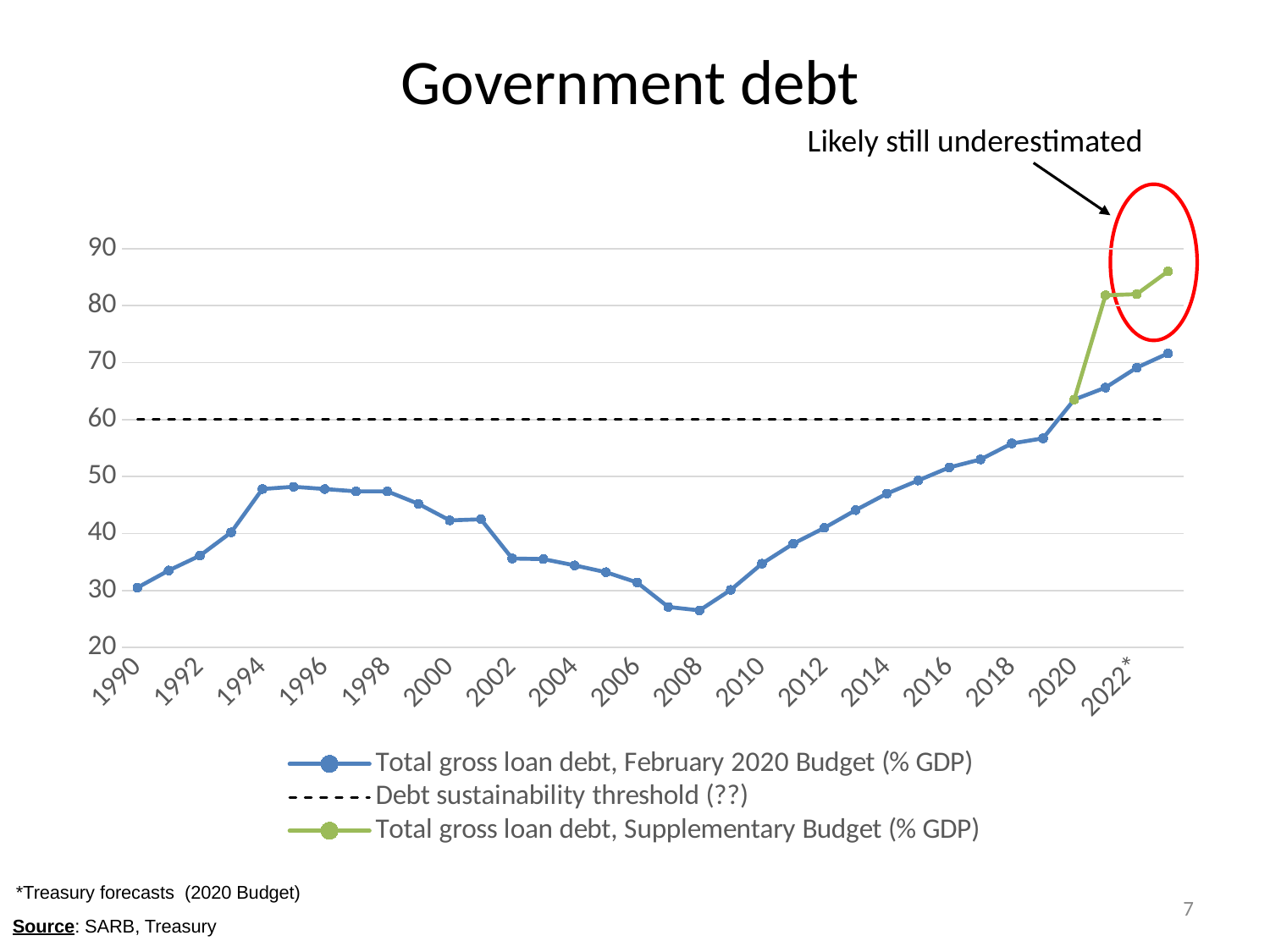
At what level on the y axis is the Debt sustainability threshold line drawn? 60 Is the value for Total gross loan debt, Supplementary Budget at the last point (after 2022*) greater or less than 80? greater At the final point on the right of the chart, which series is higher: Total gross loan debt, Supplementary Budget or Total gross loan debt, February 2020 Budget? Total gross loan debt, Supplementary Budget Is the value for Total gross loan debt, February 2020 Budget in 2020 greater or less than 60? greater In which year does the Total gross loan debt, February 2020 Budget series reach its lowest value? 2008 What colour is the line for Total gross loan debt, Supplementary Budget (% GDP)? green Is the value for Total gross loan debt, February 2020 Budget in 2016 greater or less than 50? greater What is the title of the chart? Government debt Does the Total gross loan debt, February 2020 Budget series rise or fall between 2008 and 2020? rise How many series does the legend list? 3 What kind of chart is shown on the slide? line chart